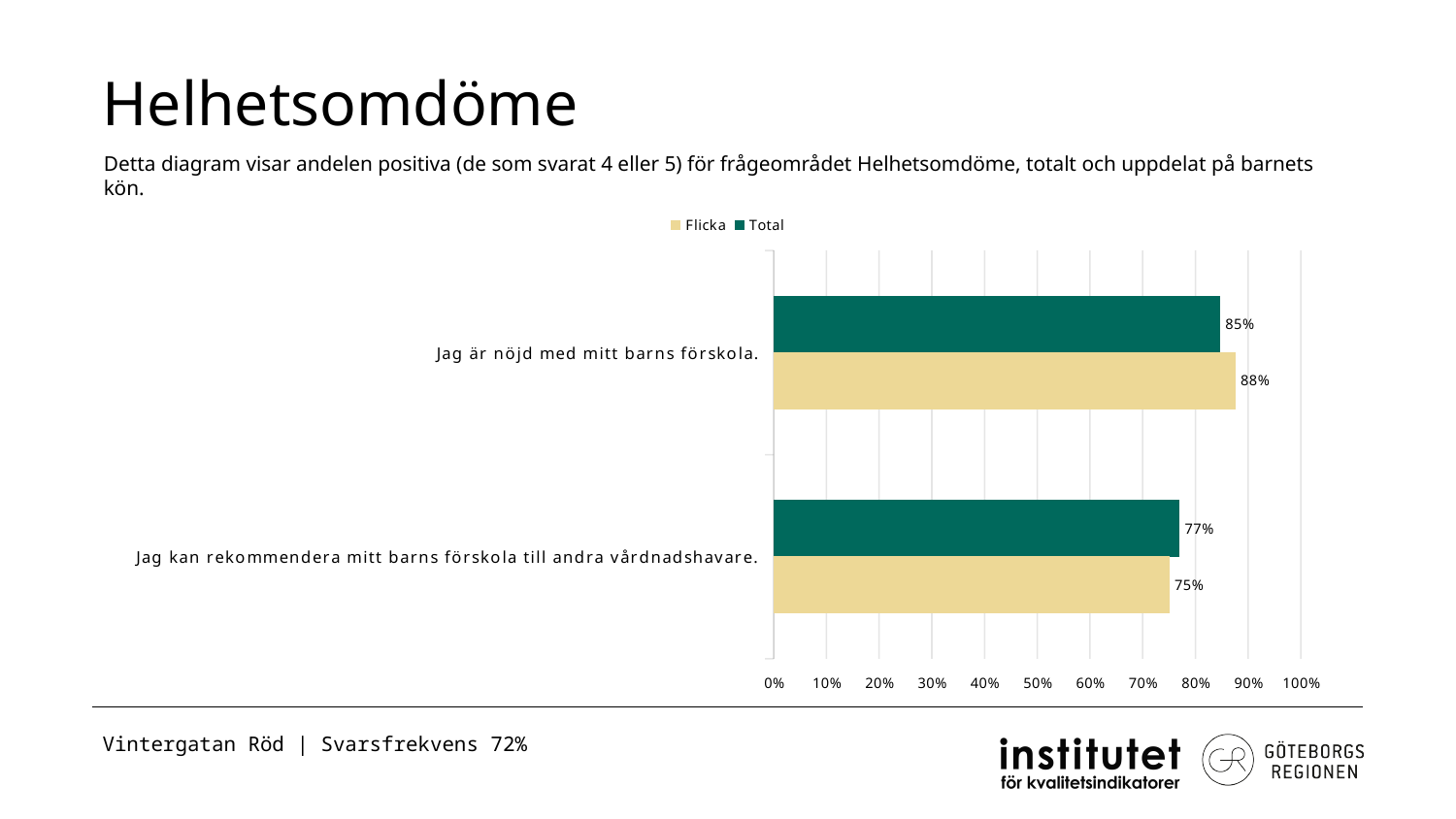
What is the Flicka value for "Jag är nöjd med mitt barns förskola."? 88% Which category has the lowest Total value? Jag kan rekommendera mitt barns förskola till andra vårdnadshavare. What is the Total value for "Jag är nöjd med mitt barns förskola."? 85% What is the Total value for "Jag kan rekommendera mitt barns förskola till andra vårdnadshavare."? 77% What is the difference between the Flicka and Total values for "Jag är nöjd med mitt barns förskola."? 3% For "Jag kan rekommendera mitt barns förskola till andra vårdnadshavare.", which is larger, the Flicka value or the Total value? Total Which category has the highest Flicka value? Jag är nöjd med mitt barns förskola. How many series does the legend list? 2 How many categories are shown in the chart? 2 What kind of chart is shown on the slide? Bar chart Is the Flicka value for "Jag är nöjd med mitt barns förskola." greater or less than 80%? greater What is the Flicka value for "Jag kan rekommendera mitt barns förskola till andra vårdnadshavare."? 75%